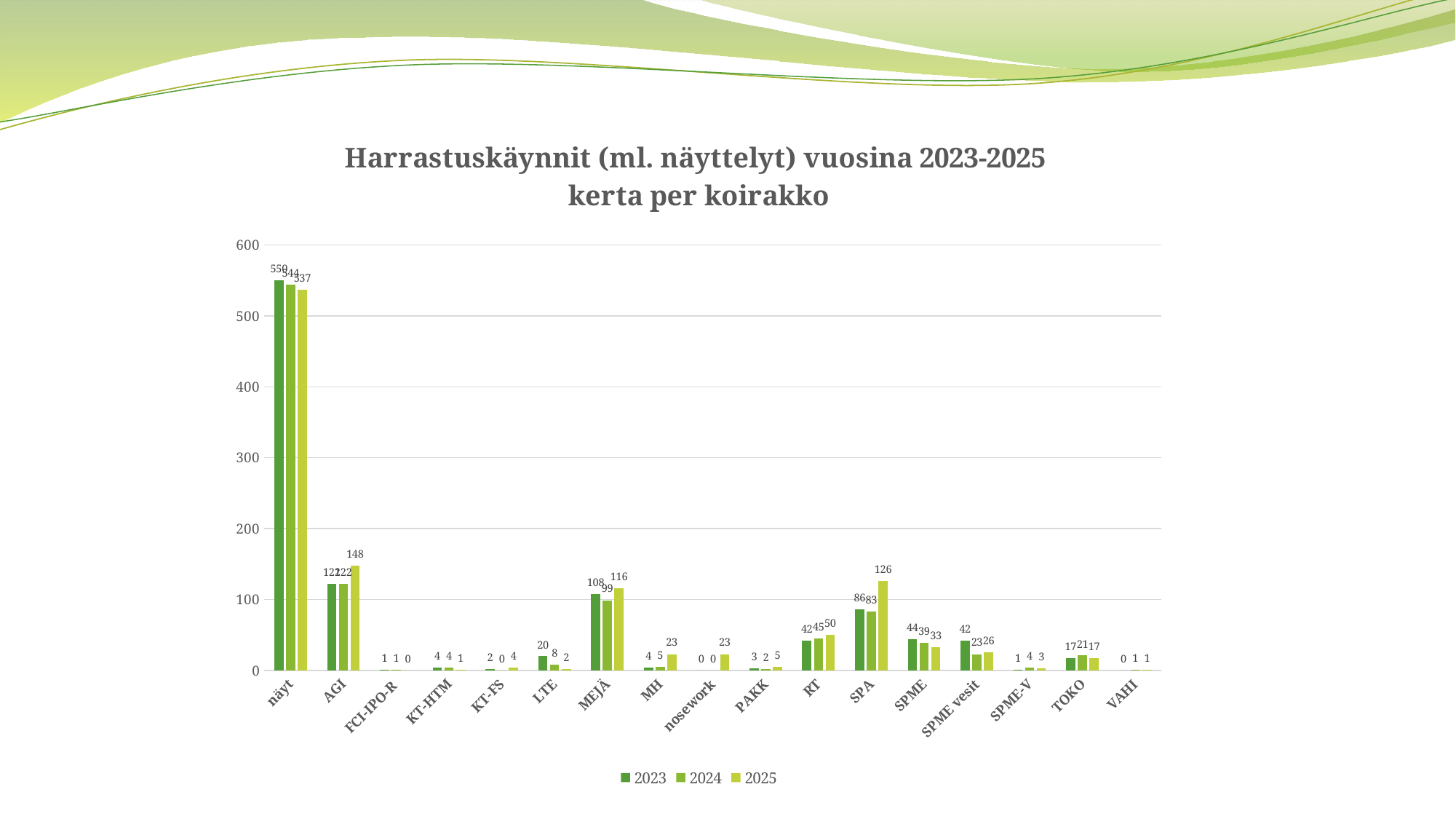
What is the value for MEJÄ in 2024? 99 What is the difference between the SPA values for 2025 and 2023? 40 Do the values for SPME rise or fall from 2023 to 2025? fall What is the value for SPA in 2025? 126 What is the value for AGI in 2025? 148 Is the value for näyt in 2023 greater or less than 500? greater How many categories are shown on the x axis? 17 Which year has the lowest value for LTE? 2025 How many series does the legend list? 3 What kind of chart is shown on the slide? bar chart Which category has the highest value in 2025? näyt Which is larger: RT in 2025 or SPME in 2023? RT in 2025